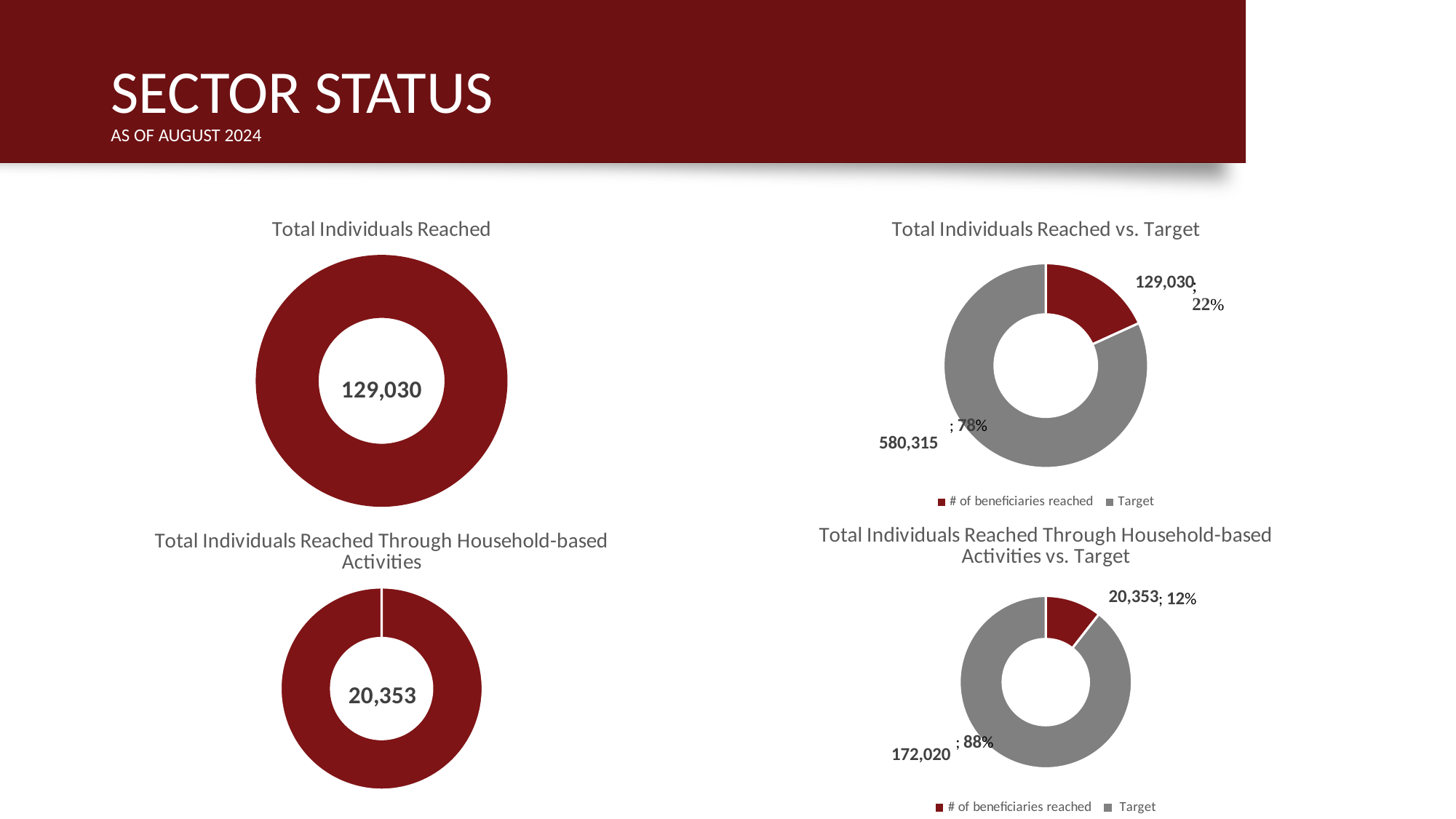
In the 'Total Individuals Reached Through Household-based Activities vs. Target' chart, which is larger, '# of beneficiaries reached' or Target? Target In the 'Total Individuals Reached vs. Target' chart, what share of the donut does '# of beneficiaries reached' represent? 22% What kind of chart is the 'Total Individuals Reached vs. Target' chart? donut chart In the 'Total Individuals Reached Through Household-based Activities vs. Target' chart, what is the difference between the Target and the number of beneficiaries reached? 151,667 In the 'Total Individuals Reached' chart, what value is shown in the centre of the donut? 129,030 In the 'Total Individuals Reached vs. Target' chart, what is the difference between the Target and the number of beneficiaries reached? 451,285 In the 'Total Individuals Reached Through Household-based Activities vs. Target' chart, what share of the donut does '# of beneficiaries reached' represent? 12% In the 'Total Individuals Reached Through Household-based Activities vs. Target' chart, what is the value for Target? 172,020 In the 'Total Individuals Reached vs. Target' chart, what share of the donut does Target represent? 78% How many entries does the legend of the 'Total Individuals Reached vs. Target' chart list? 2 In the 'Total Individuals Reached Through Household-based Activities' chart, what value is shown in the centre of the donut? 20,353 In the 'Total Individuals Reached vs. Target' chart, what is the value for Target? 580,315